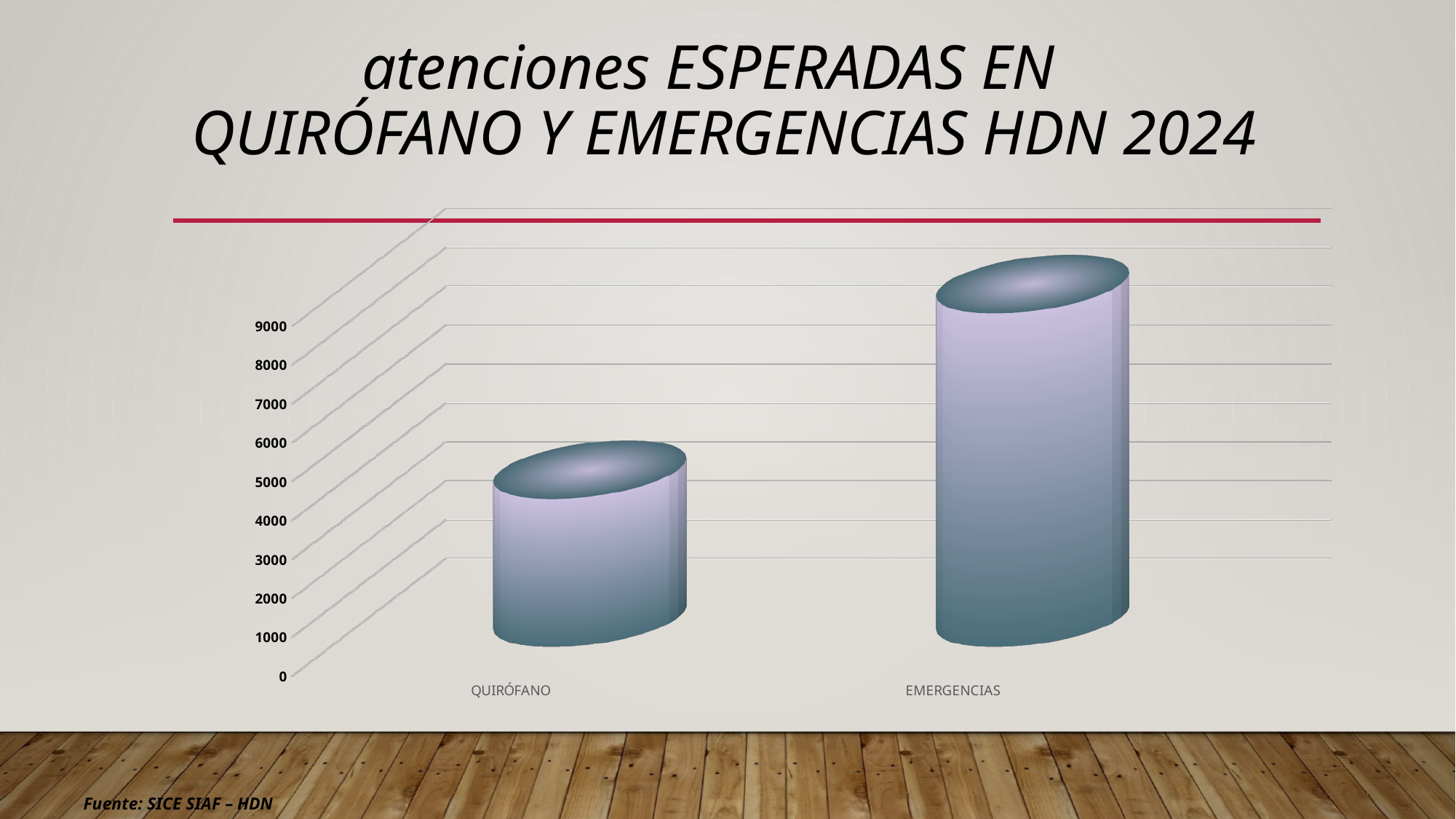
Is the value for QUIRÓFANO greater or less than 8000? less Is the value for QUIRÓFANO greater or less than 3000? greater Which is larger, the value for QUIRÓFANO or the value for EMERGENCIAS? EMERGENCIAS Do the values rise or fall from QUIRÓFANO to EMERGENCIAS? rise How many categories are plotted on the chart? 2 What source is cited at the bottom of the slide? SICE SIAF – HDN What is the title of the slide containing the chart? atenciones ESPERADAS EN QUIRÓFANO Y EMERGENCIAS HDN 2024 What kind of chart is shown on the slide? Bar chart Is the value for EMERGENCIAS greater or less than 7000? greater Which category has the lowest value? QUIRÓFANO Which category has the highest value? EMERGENCIAS